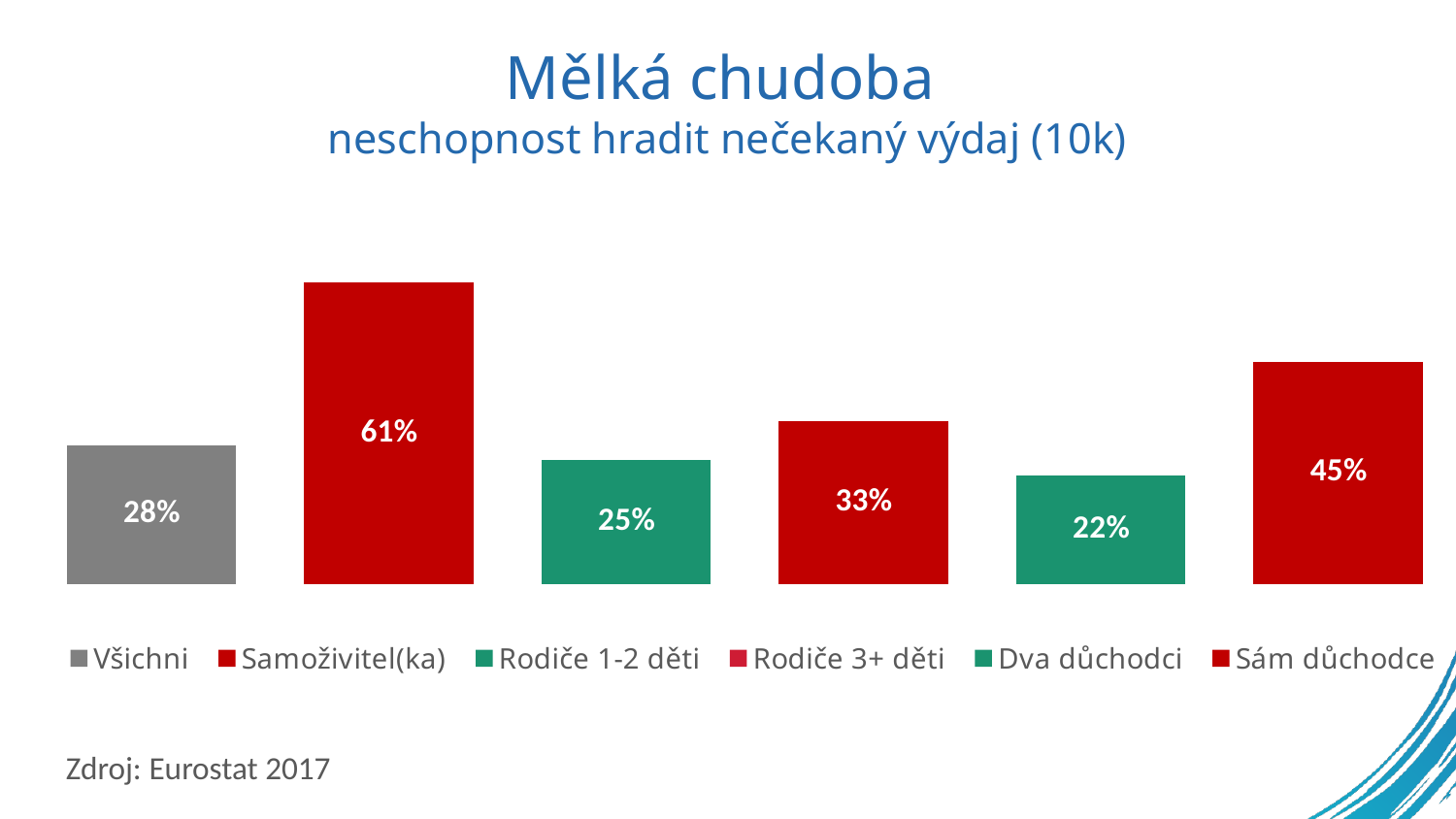
Which is larger, the value for Rodiče 3+ děti or the value for Všichni? Rodiče 3+ děti What is the difference between the values for Samoživitel(ka) and Sám důchodce? 16% What is the value for Dva důchodci? 22% Which category has the highest value? Samoživitel(ka) What is the difference between the values for Rodiče 3+ děti and Rodiče 1-2 děti? 8% What is the value for Sám důchodce? 45% What is the value for Samoživitel(ka)? 61% What is the source cited below the chart? Eurostat 2017 How many categories are shown in the chart? 6 Which category has the lowest value? Dva důchodci What is the value for Všichni? 28% What kind of chart is shown on the slide? Bar chart